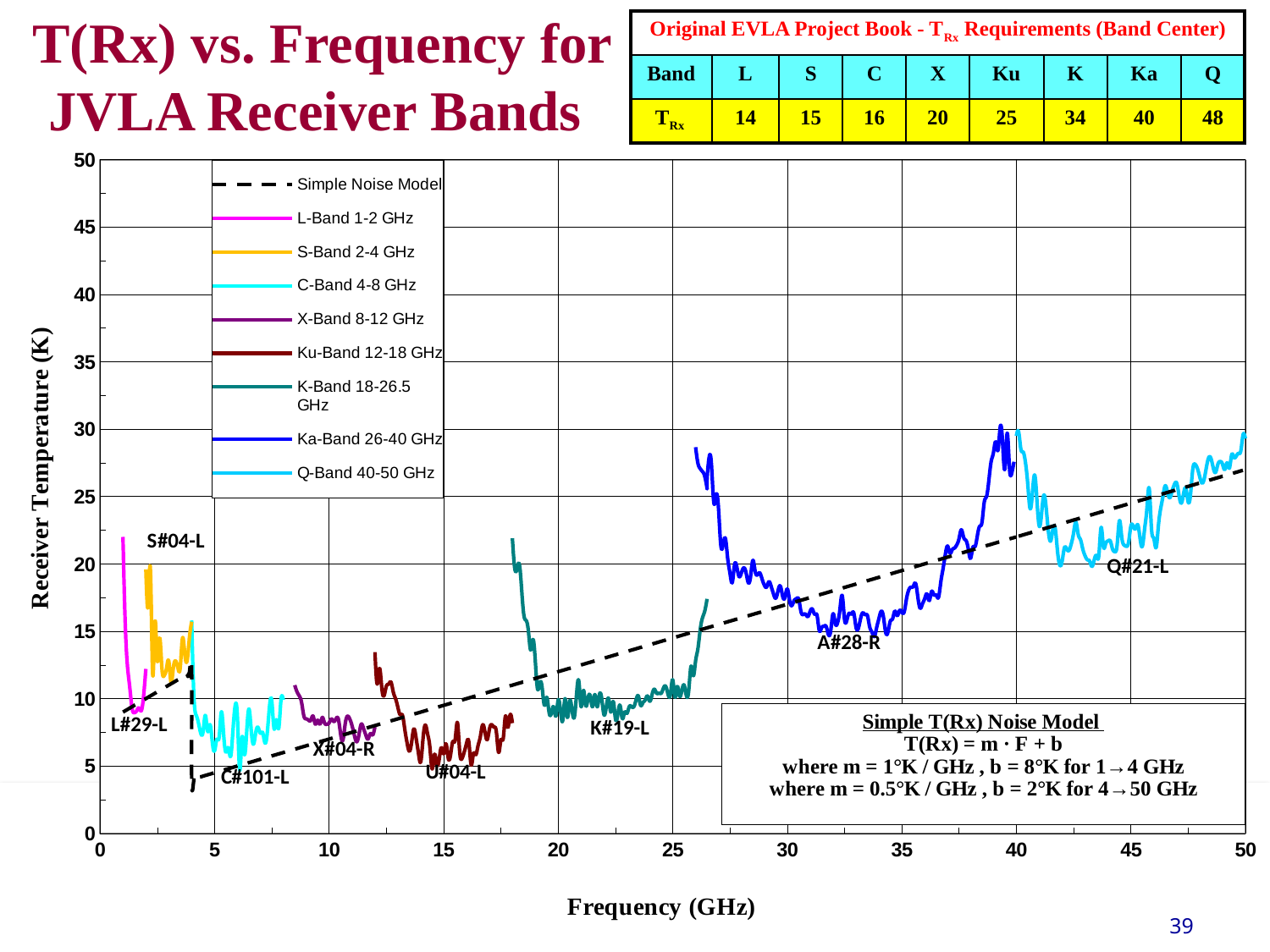
What is the label of the chart's y axis? Receiver Temperature (K) Is the lowest value of the C-Band 4-8 GHz series greater or less than 10 K? less Is the value of the Q-Band 40-50 GHz series at 50 GHz greater or less than 25 K? greater Is the lowest value of the Ku-Band 12-18 GHz series greater or less than 10 K? less How many series does the chart legend list? 9 Does the Simple Noise Model dashed line rise or fall as frequency increases from 5 GHz to 50 GHz? rise Which series is drawn as a dashed black line in the chart? Simple Noise Model What kind of chart is shown on the slide? line chart What is the label of the chart's x axis? Frequency (GHz)